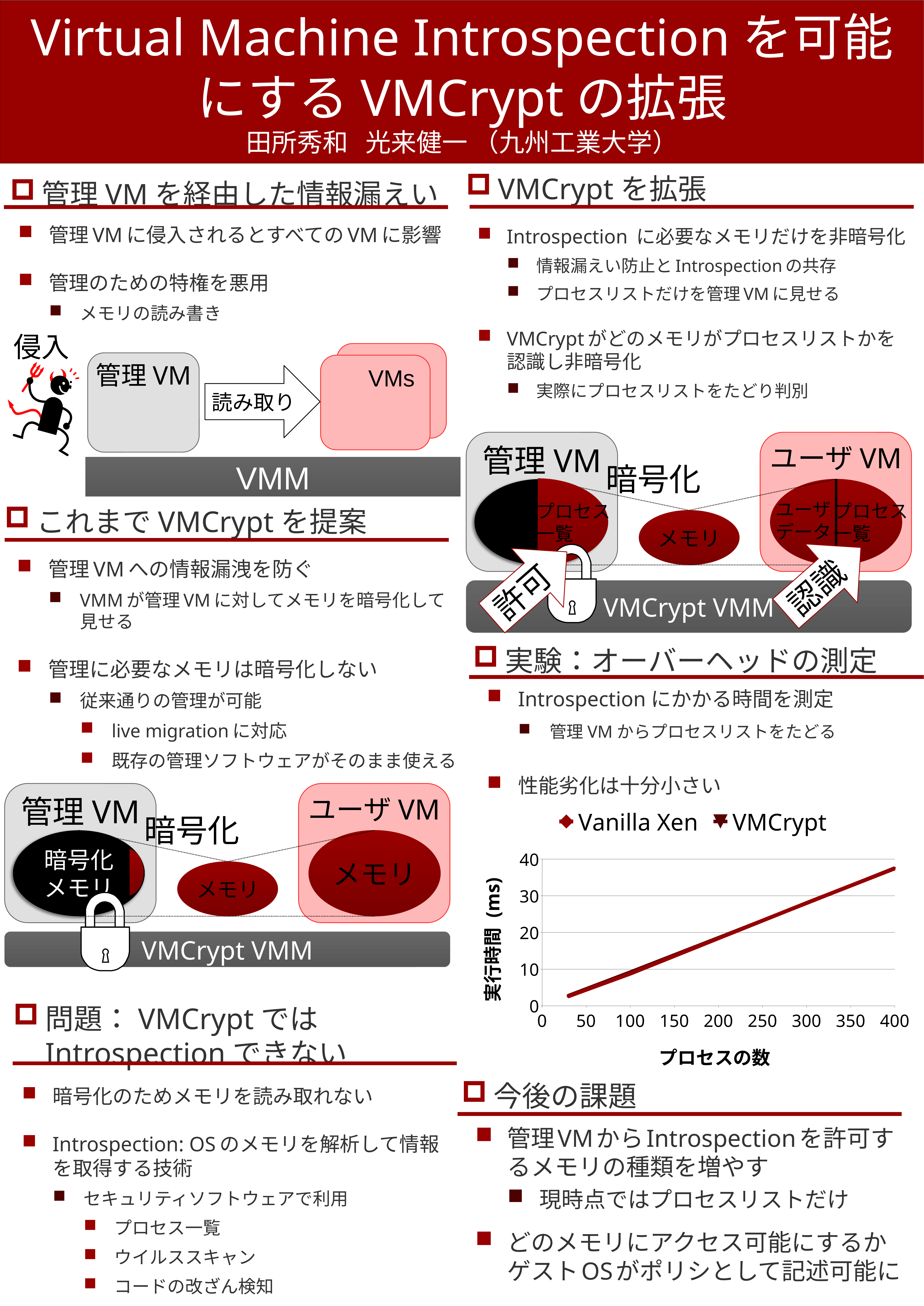
In the line chart, is the execution time at 400 processes greater or less than 30 ms? greater What is the largest value shown on the x axis of the line chart? 400 In the line chart, does the execution time rise or fall as the number of processes (プロセスの数) increases? rise What is the largest value shown on the y axis of the line chart? 40 How many series does the legend of the line chart list? 2 In the line chart, is the execution time at 300 processes greater or less than 20 ms? greater What are the two series named in the legend of the line chart? Vanilla Xen and VMCrypt In the line chart, is the execution time at 50 processes greater or less than 10 ms? less What kind of chart is shown under the 実験：オーバーヘッドの測定 section? line chart What is the label of the y axis of the line chart? 実行時間 (ms)